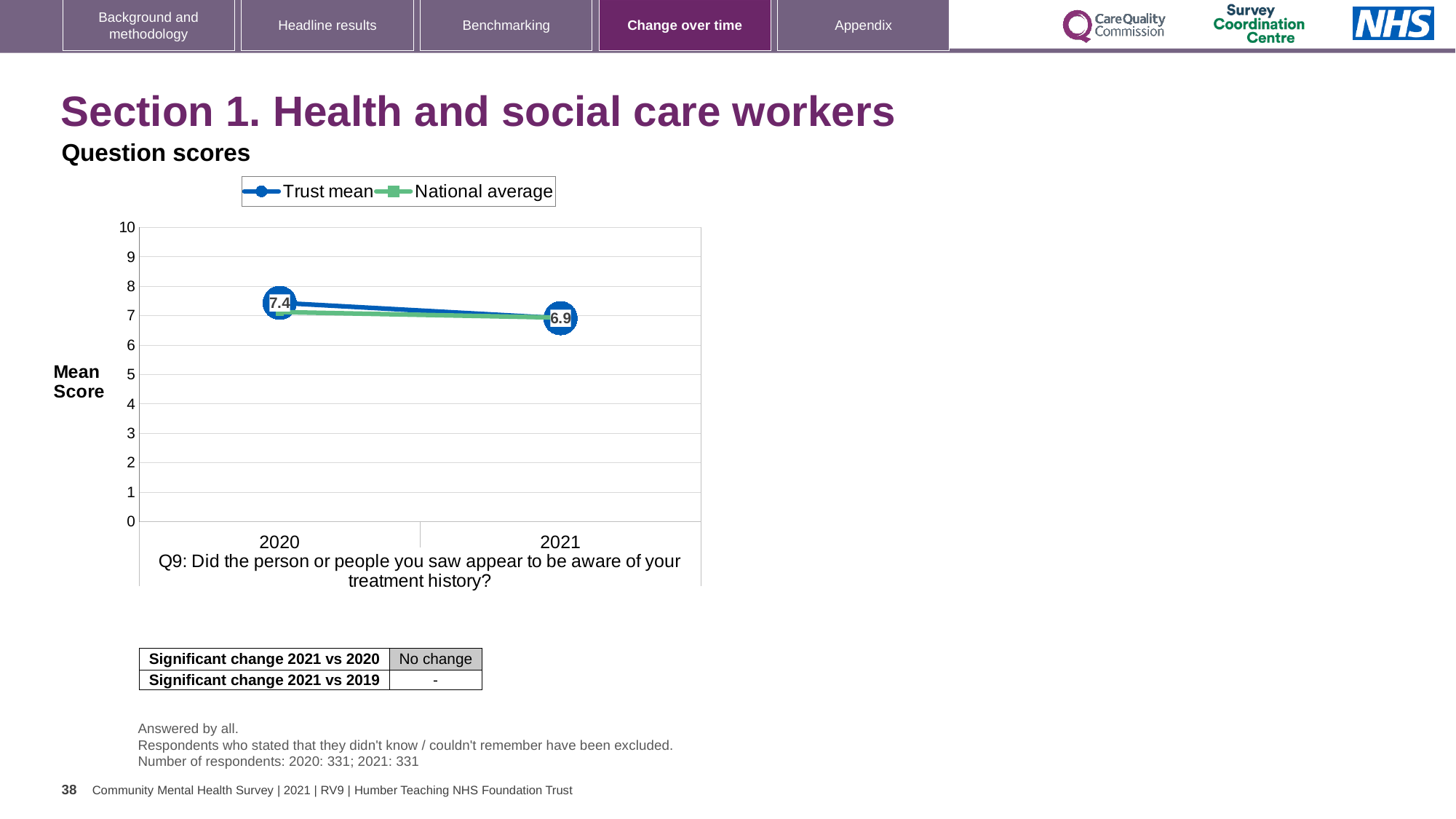
What is the Trust mean score for 2021? 6.9 By how much did the Trust mean score fall from 2020 to 2021? 0.5 Is the National average value for 2020 greater or less than 5? greater What kind of chart is shown on the slide? line chart What is the Trust mean score for 2020? 7.4 In which year is the Trust mean score higher, 2020 or 2021? 2020 What is the label on the y axis of the chart? Mean Score Does the Trust mean score rise or fall from 2020 to 2021? fall How many series does the legend list? 2 Is the Trust mean value for 2021 greater or less than 8? less What are the two series named in the legend? Trust mean and National average How many years are plotted on the x axis? 2